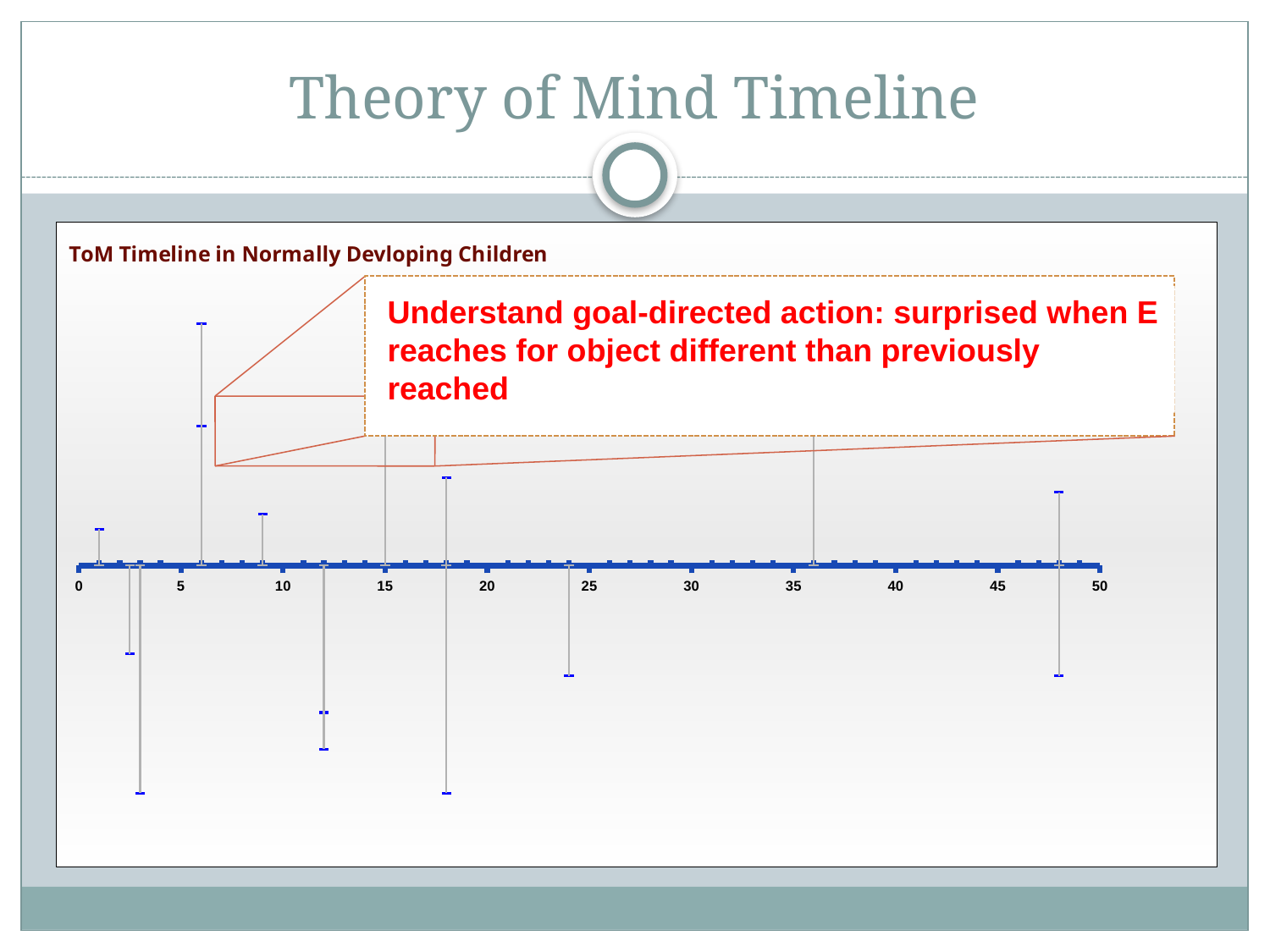
What is the highest value labelled on the chart's horizontal axis? 50 What is the lowest value labelled on the chart's horizontal axis? 0 What text appears in the callout box on the chart? Understand goal-directed action: surprised when E reaches for object different than previously reached What is the title of the chart on the slide? ToM Timeline in Normally Devloping Children What is the interval between labelled ticks on the chart's horizontal axis? 5